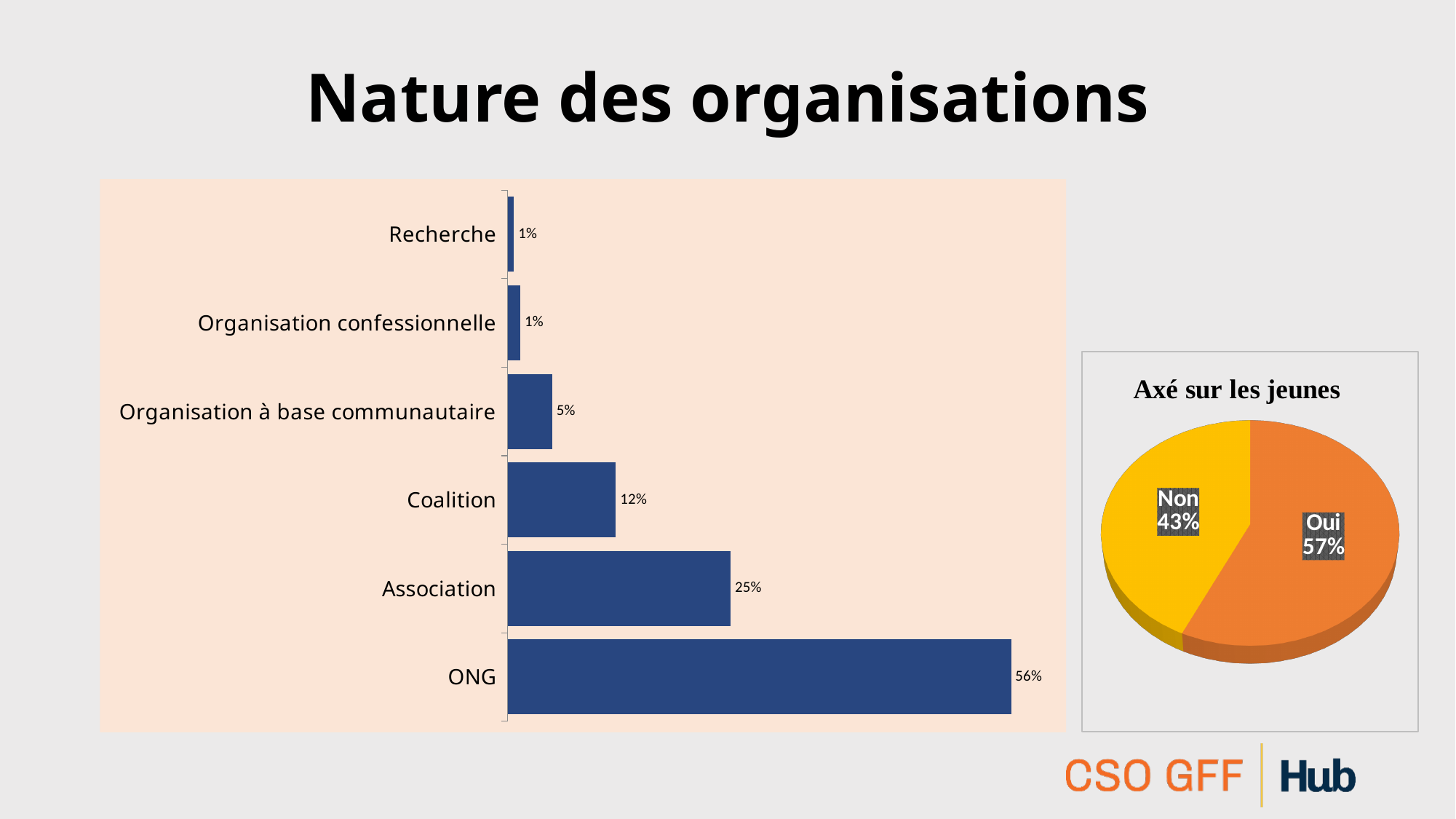
In the bar chart on the left, what is the difference between the values for ONG and Association? 31% What kind of chart is the chart titled 'Axé sur les jeunes'? Pie chart How many categories does the bar chart on the left show? 6 In the pie chart titled 'Axé sur les jeunes', what share does Non have? 43% In the bar chart on the left, what is the value for Association? 25% What kind of chart is the chart on the left of the slide? Bar chart In the pie chart titled 'Axé sur les jeunes', what share does Oui have? 57% In the bar chart on the left, which is larger, the value for Coalition or the value for Organisation à base communautaire? Coalition In the bar chart on the left, what is the value for Organisation à base communautaire? 5% In the bar chart on the left, what is the value for Coalition? 12% In the bar chart on the left, what is the value for ONG? 56% In the bar chart on the left, which category has the highest value? ONG